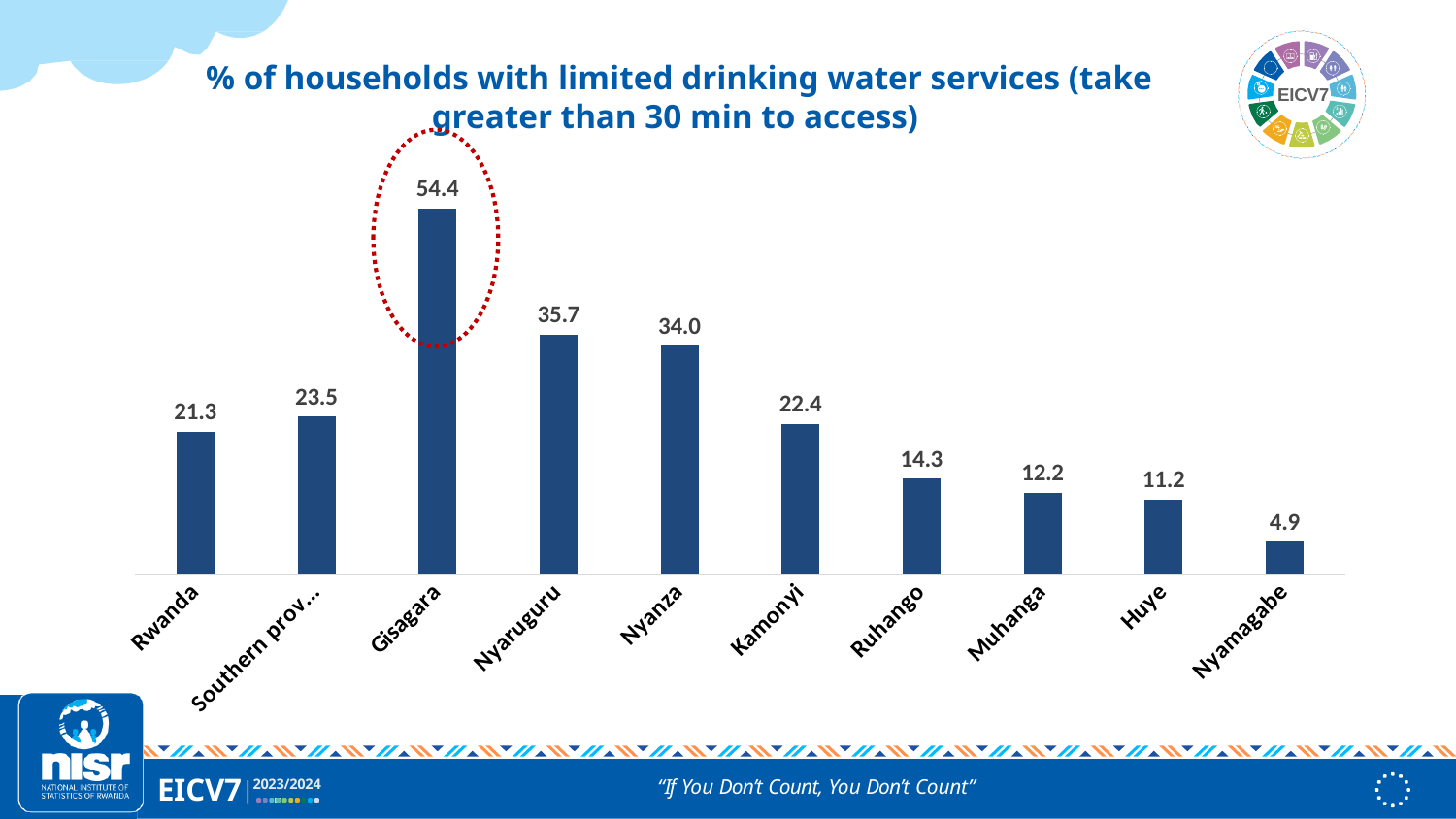
What is the value for Nyamagabe? 4.9 What is the value for Rwanda? 21.3 What is the difference between the values for Gisagara and Nyaruguru? 18.7 What is the value for Gisagara? 54.4 Which bar is highlighted with a red dotted circle? Gisagara Which category has the lowest value? Nyamagabe Which category has the highest value? Gisagara What is the value for Kamonyi? 22.4 How many categories are shown on the x axis? 10 What kind of chart is shown on the slide? Bar chart What is the difference between the values for Nyanza and Rwanda? 12.7 Which is larger, the value for Muhanga or the value for Huye? Muhanga